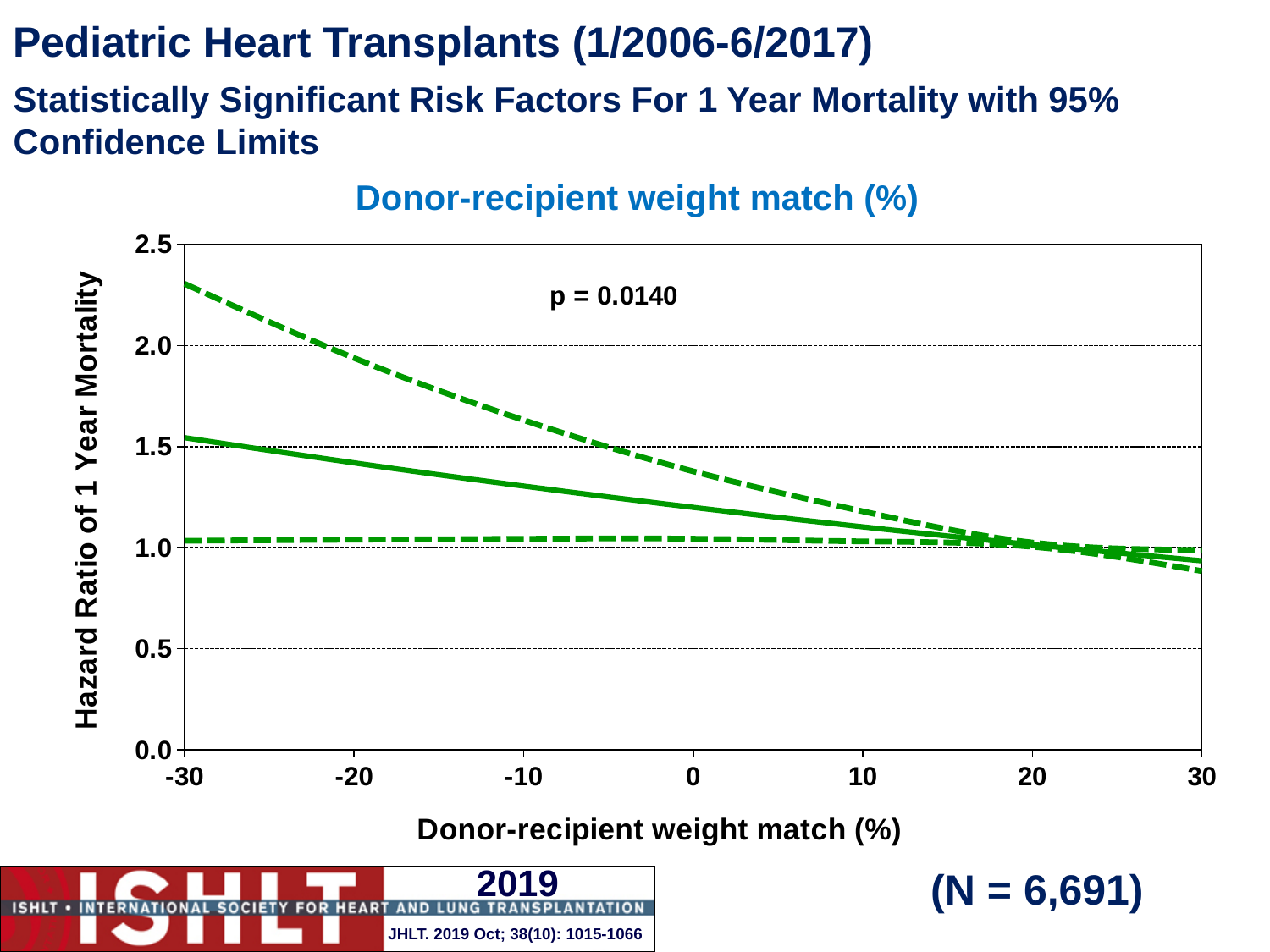
How many lines are plotted on the chart? 3 Is the value of the upper dashed confidence limit at a donor-recipient weight match of -10% greater or less than 1.5? greater What kind of chart is shown on the slide? line chart Is the value of the solid hazard ratio line at a donor-recipient weight match of 0% greater or less than 1.0? greater What is the lowest value shown on the x axis? -30 Is the value of the upper dashed confidence limit at a donor-recipient weight match of -30% greater or less than 2.0? greater What is the highest value shown on the y axis? 2.5 Does the solid hazard ratio line rise or fall as donor-recipient weight match increases from -30 to 30? fall What is the p-value printed on the chart? p = 0.0140 What is the label of the y axis? Hazard Ratio of 1 Year Mortality